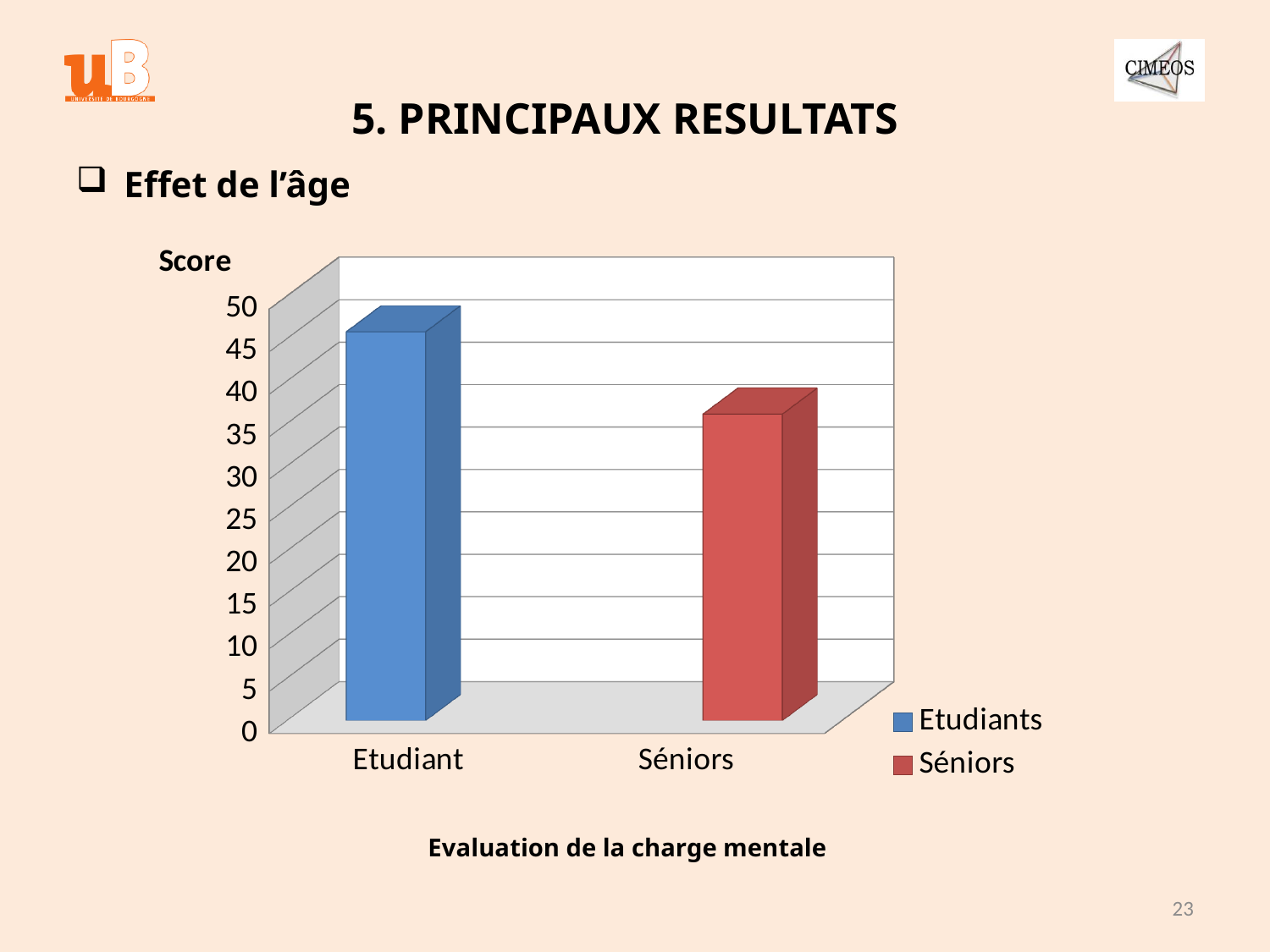
What type of chart is shown on the slide? bar chart What is the title shown below the chart? Evaluation de la charge mentale Which has a higher score, Etudiant or Séniors? Etudiant Is the score for Etudiant greater or less than 50? less Is the score for Séniors greater or less than 30? greater What label is given to the vertical axis of the chart? Score Which category has the highest score in the chart? Etudiant Which category has the lowest score in the chart? Séniors Is the score for Etudiant greater or less than 40? greater How many entries does the chart legend list? 2 How many bars are plotted in the chart? 2